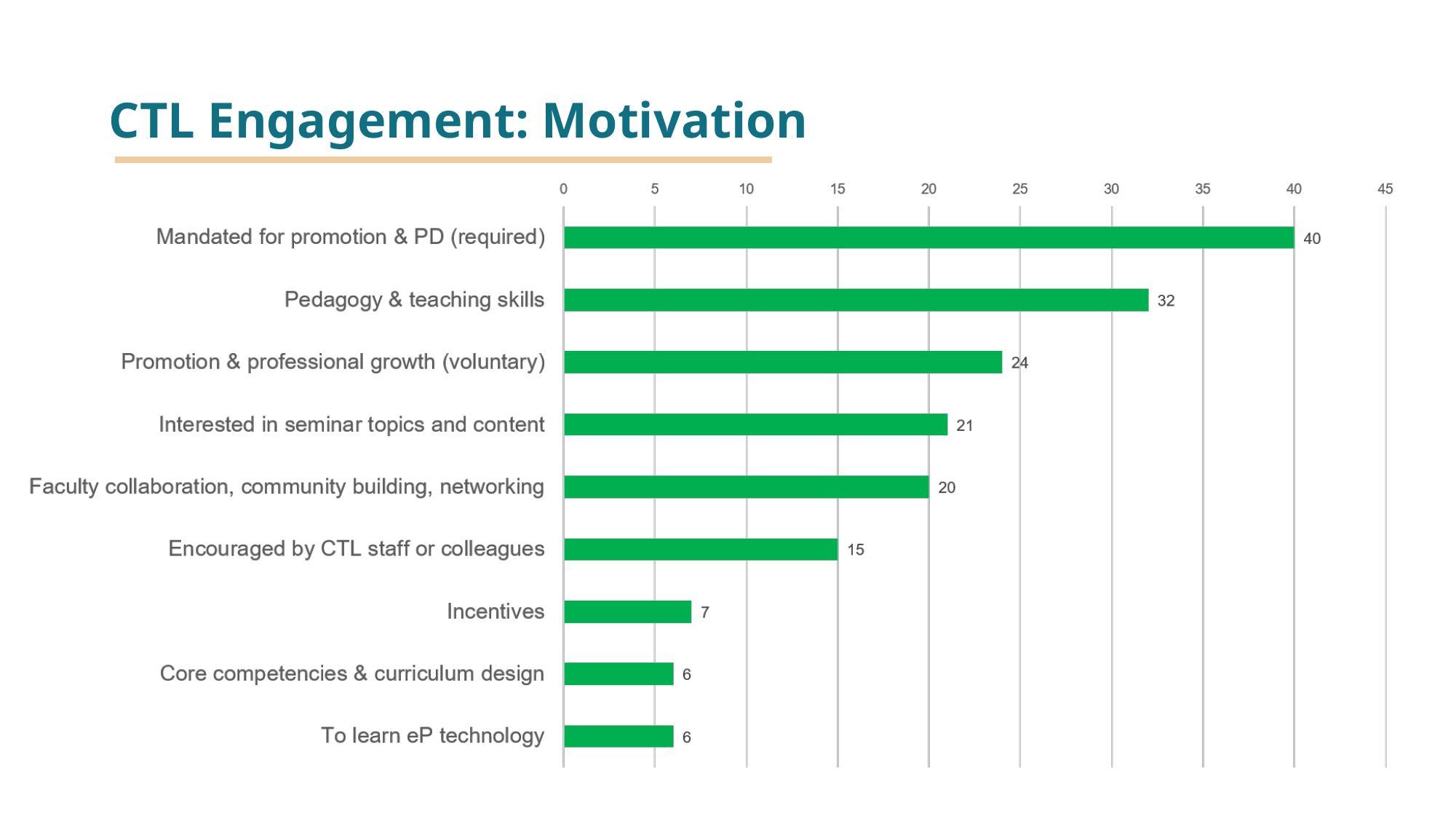
Is the value for 'Promotion & professional growth (voluntary)' greater or less than 20? greater What kind of chart is shown on the slide? Bar chart What is the title of the slide? CTL Engagement: Motivation What is the value for 'Incentives'? 7 What is the value for 'Pedagogy & teaching skills'? 32 What is the difference between 'Pedagogy & teaching skills' and 'Promotion & professional growth (voluntary)'? 8 How many categories are shown in the chart? 9 What is the value for 'Mandated for promotion & PD (required)'? 40 Which is larger: 'Interested in seminar topics and content' or 'Encouraged by CTL staff or colleagues'? Interested in seminar topics and content Which category has the highest value? Mandated for promotion & PD (required) What is the value for 'Encouraged by CTL staff or colleagues'? 15 What is the difference between 'Mandated for promotion & PD (required)' and 'Faculty collaboration, community building, networking'? 20